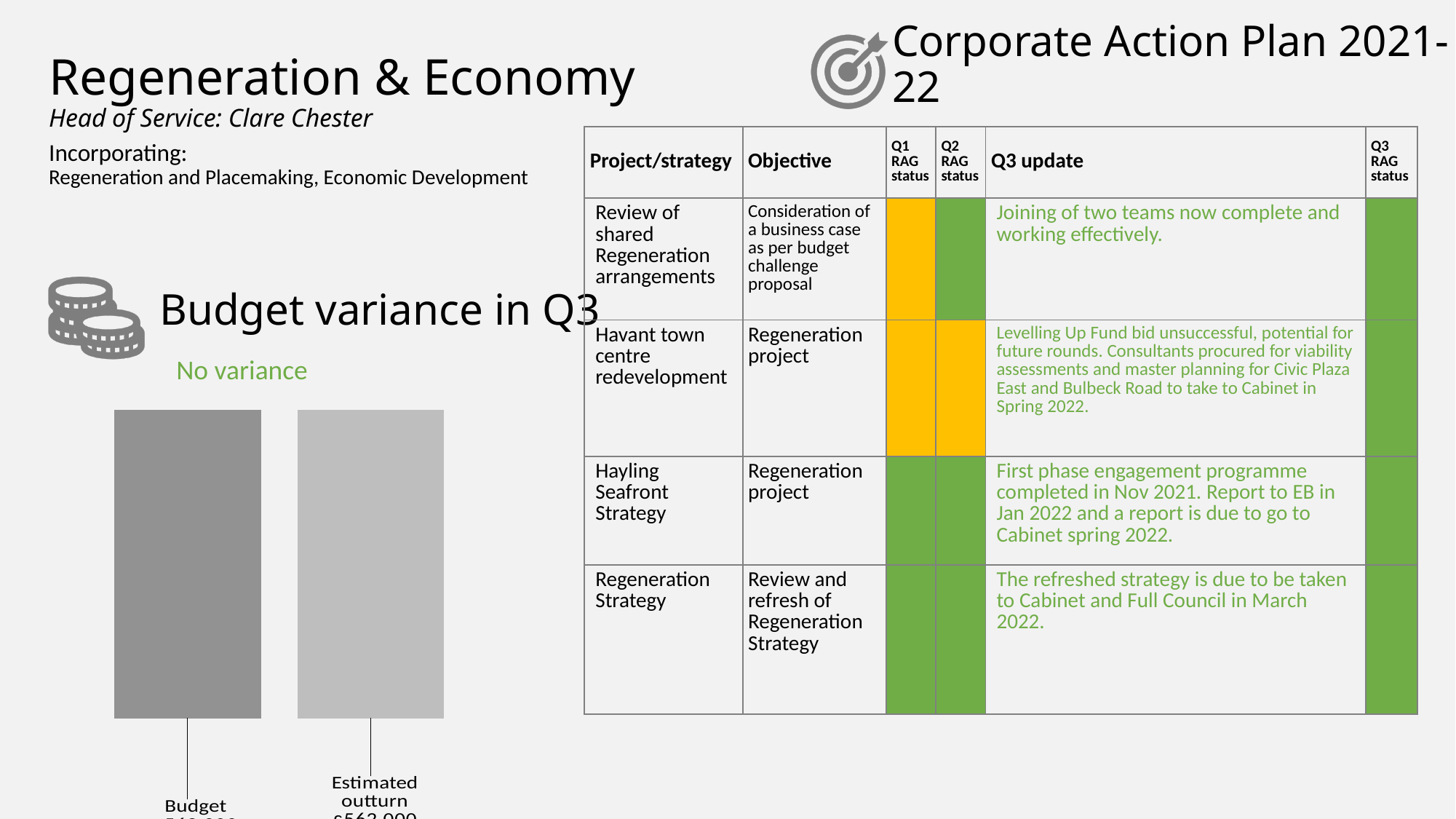
What are the two categories plotted in the 'Budget variance in Q3' chart? Budget and Estimated outturn How many bars does the 'Budget variance in Q3' chart show? 2 What does the green text above the 'Budget variance in Q3' chart say about the variance? No variance Which bar in the 'Budget variance in Q3' chart is drawn in the darker grey, Budget or Estimated outturn? Budget In the 'Budget variance in Q3' chart, is the Budget bar taller than, shorter than, or the same height as the Estimated outturn bar? The same height What kind of chart is shown under the heading 'Budget variance in Q3'? Bar chart